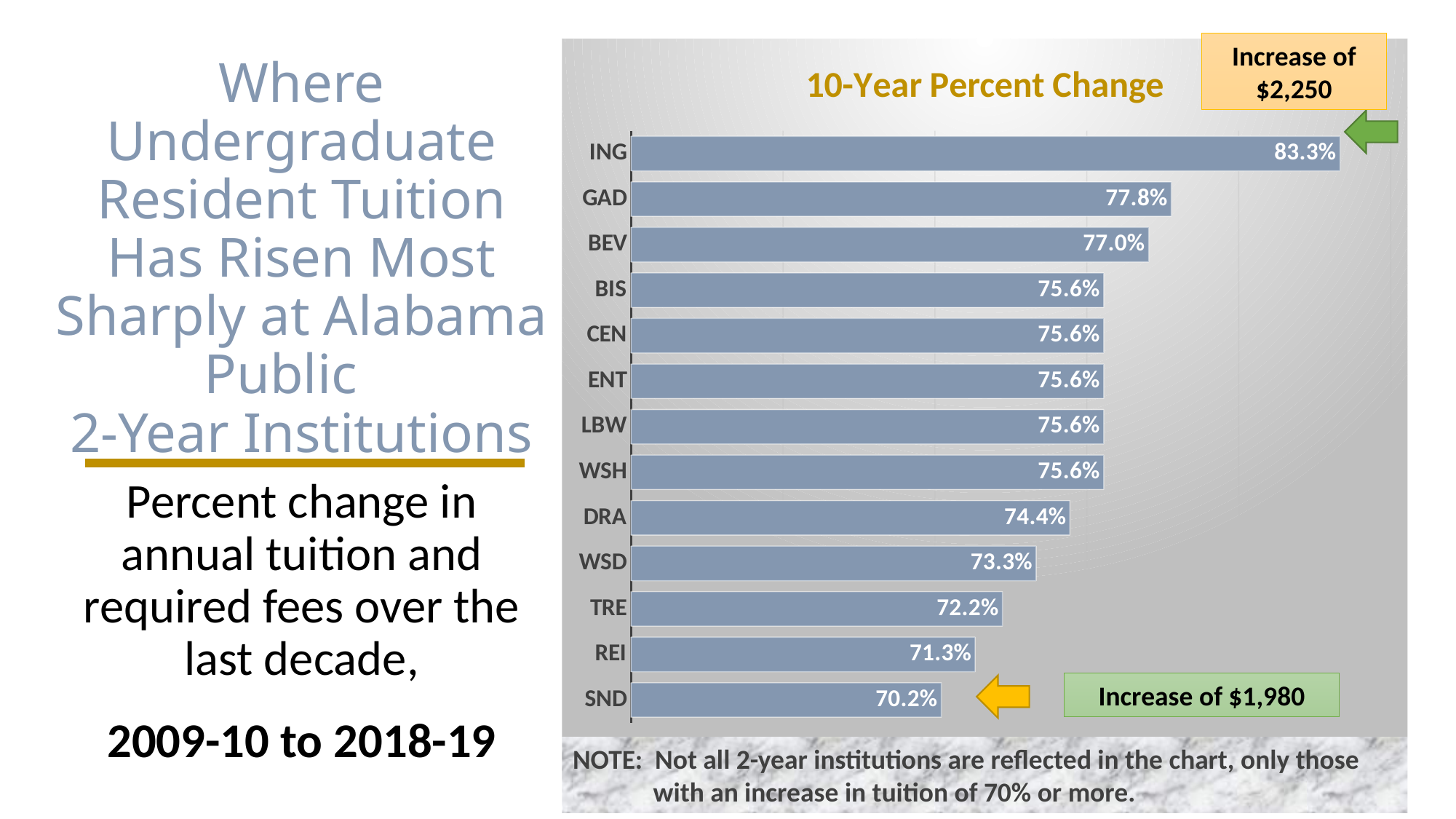
What is the title of the chart? 10-Year Percent Change Which institution has the lowest 10-year percent change? SND What kind of chart is shown on the slide? Bar chart Which institution has the highest 10-year percent change? ING What is the difference between the percent change for ING and SND? 13.1% Which has a larger 10-year percent change, WSD or TRE? WSD What is the 10-year percent change for SND? 70.2% What is the 10-year percent change for GAD? 77.8% How many institutions are shown in the chart? 13 What is the 10-year percent change for DRA? 74.4% What is the 10-year percent change for ING? 83.3% What is the difference between the percent change for GAD and BEV? 0.8%